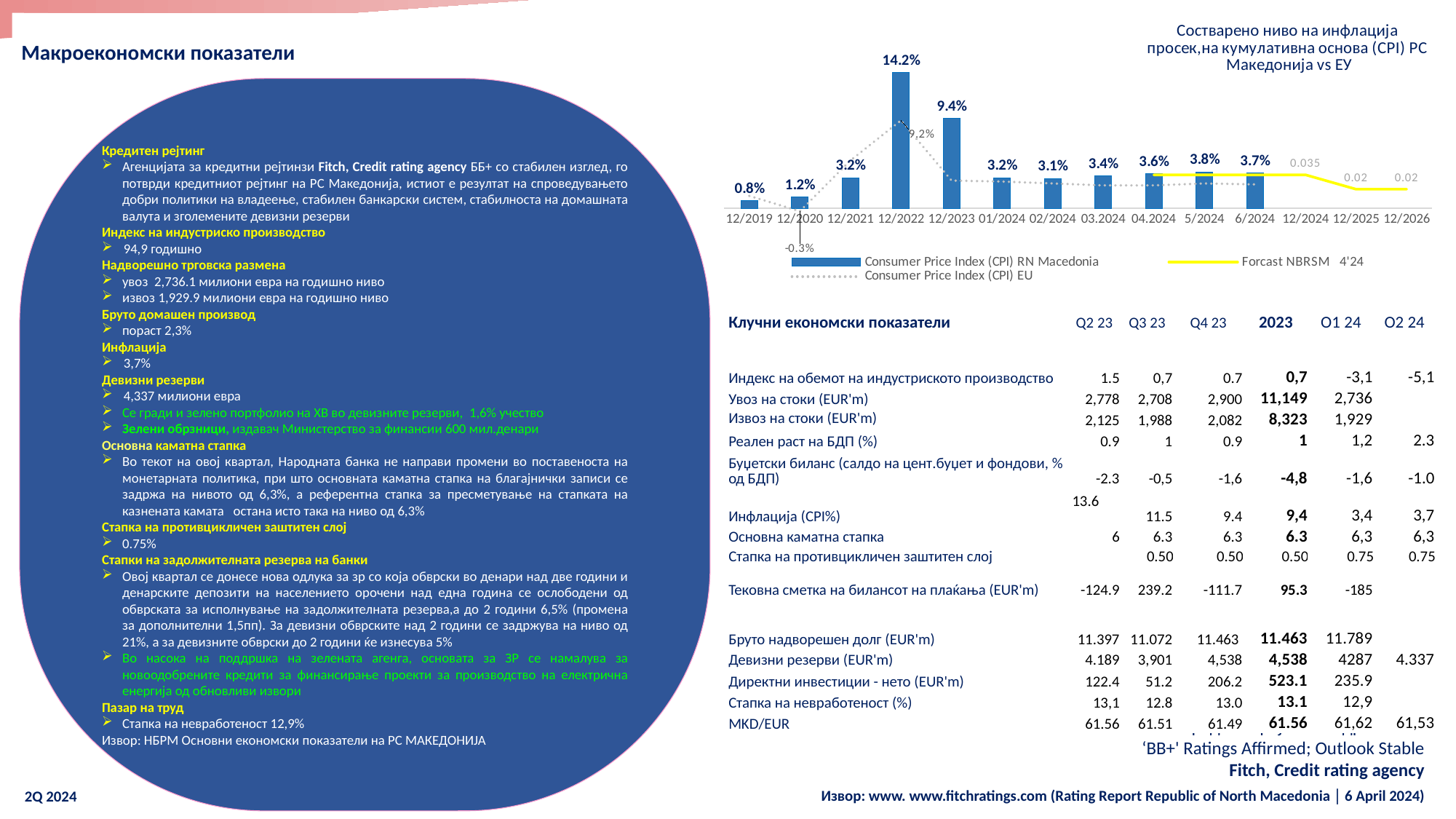
What kind of chart is shown on the slide? Bar chart with line series What is the legend entry for the yellow line? Forcast NBRSM 4'24 Which period has the lowest CPI bar for RN Macedonia? 12/2019 What is the difference between the CPI values for RN Macedonia at 12/2022 and 12/2023? 4.8% How many bars are plotted for the Consumer Price Index (CPI) RN Macedonia series? 11 Do the CPI bars for RN Macedonia rise or fall from 12/2022 to 02/2024? Fall What is the CPI value for RN Macedonia at 12/2022? 14.2% Which period has the highest CPI bar for RN Macedonia? 12/2022 What is the CPI value for RN Macedonia at 6/2024? 3.7% What is the CPI value for RN Macedonia at 12/2023? 9.4% How many series does the legend list? 3 Which is larger, the CPI value for RN Macedonia at 5/2024 or at 6/2024? 5/2024